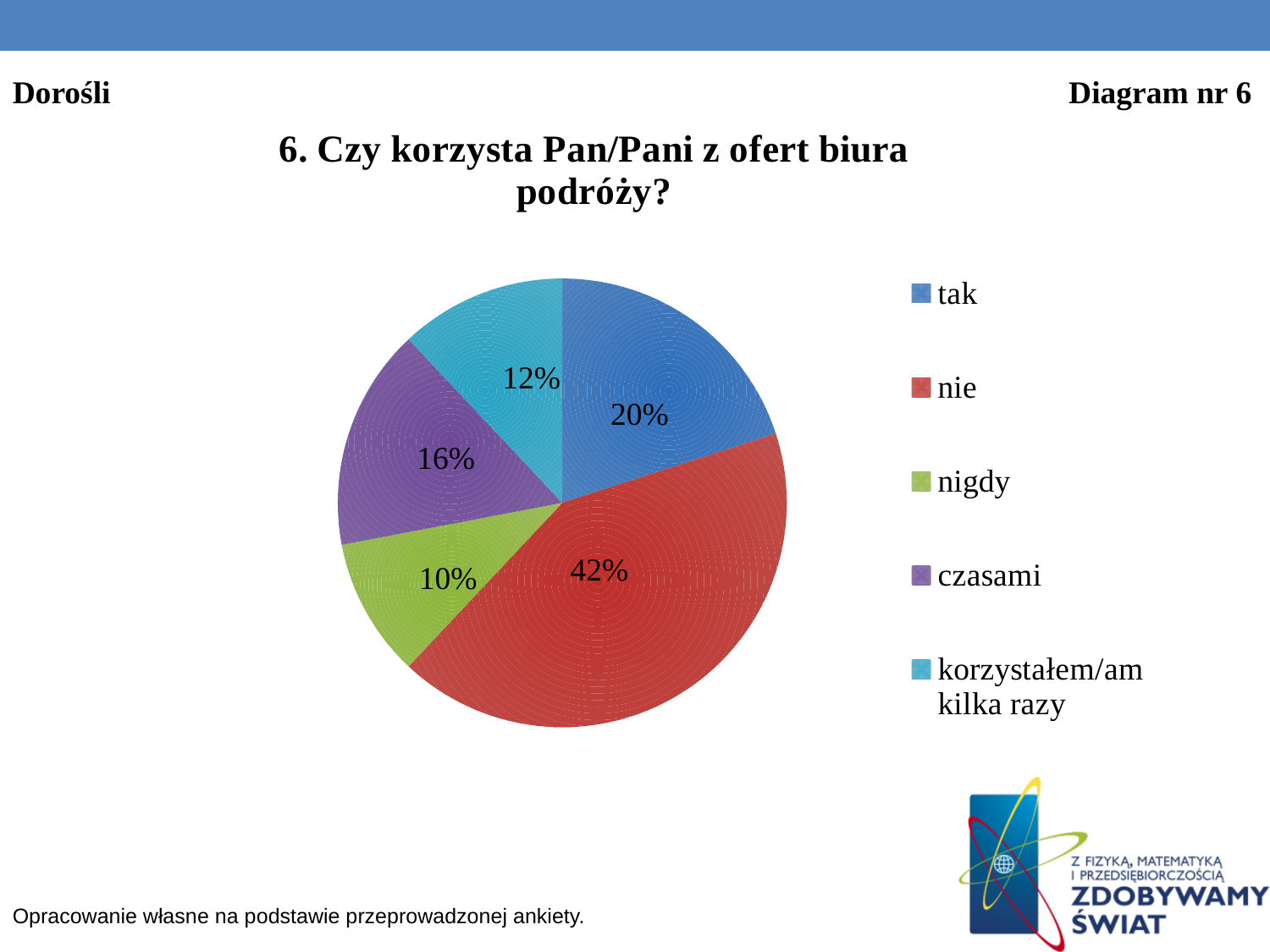
Which answer has the largest share of the pie? nie What is the difference in percentage points between "nie" and "tak"? 22 Which answer has the smallest share of the pie? nigdy How many categories does the legend list? 5 What percentage of respondents answered "korzystałem/am kilka razy"? 12% What percentage of respondents answered "tak"? 20% Which is larger, the share for "czasami" or the share for "korzystałem/am kilka razy"? czasami What percentage of respondents answered "czasami"? 16% What kind of chart is shown on the slide? pie chart What percentage of respondents answered "nie"? 42% What percentage of respondents answered "nigdy"? 10% What is the title of the chart? 6. Czy korzysta Pan/Pani z ofert biura podróży?